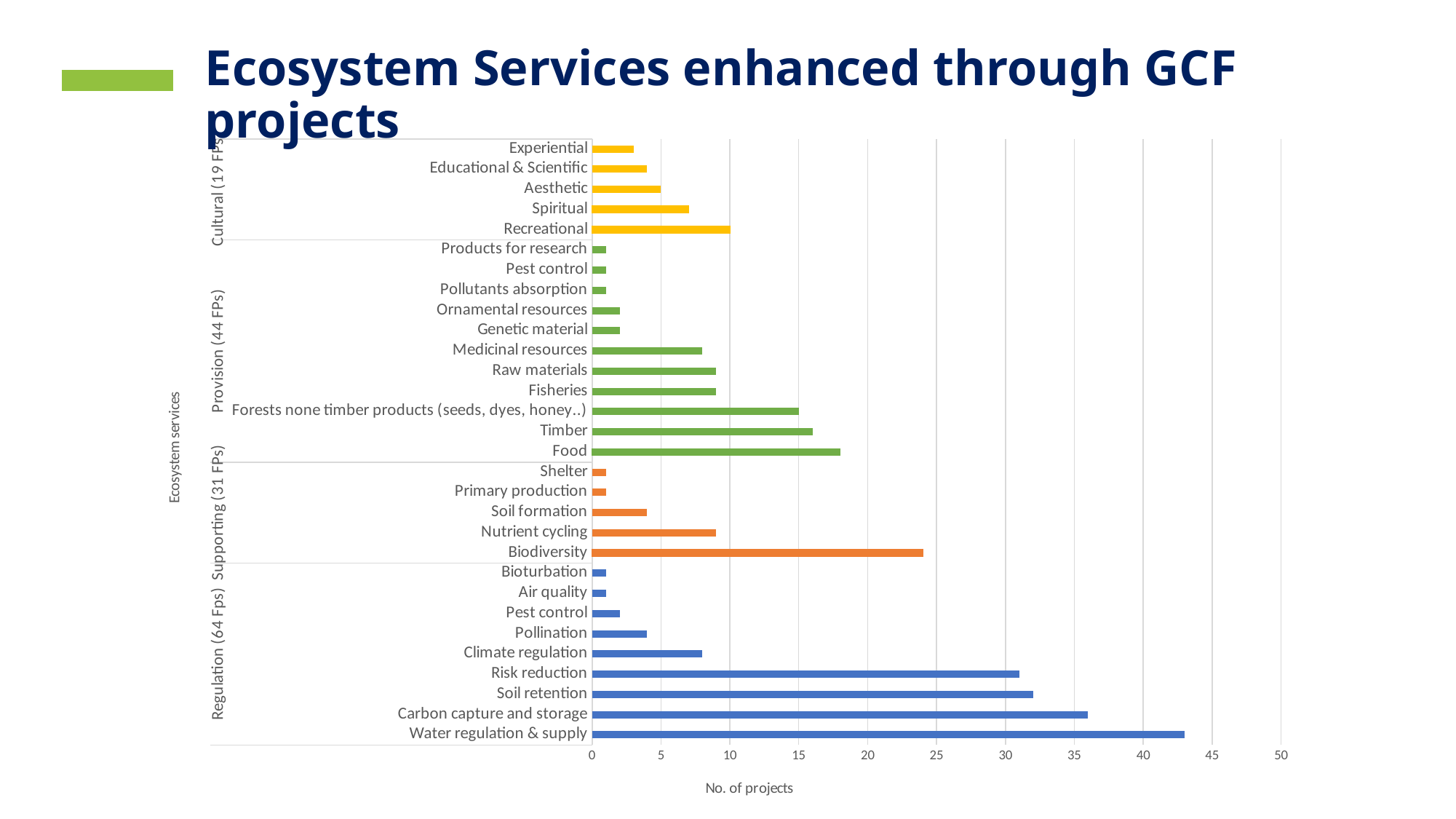
What is the title of the horizontal axis? No. of projects Is the value for Biodiversity greater or less than 20? greater How many ecosystem service categories are plotted in the chart? 30 What kind of chart is shown on the slide? Bar chart What is the number of projects for Aesthetic? 5 Which has more projects, Biodiversity or Risk reduction? Risk reduction Which has more projects, Food or Timber? Food Is the value for Water regulation & supply greater or less than 40? greater What is the number of projects for Forests none timber products (seeds, dyes, honey..)? 15 Which ecosystem service has the highest number of projects? Water regulation & supply Is the value for Climate regulation greater or less than 10? less What is the number of projects for Recreational? 10